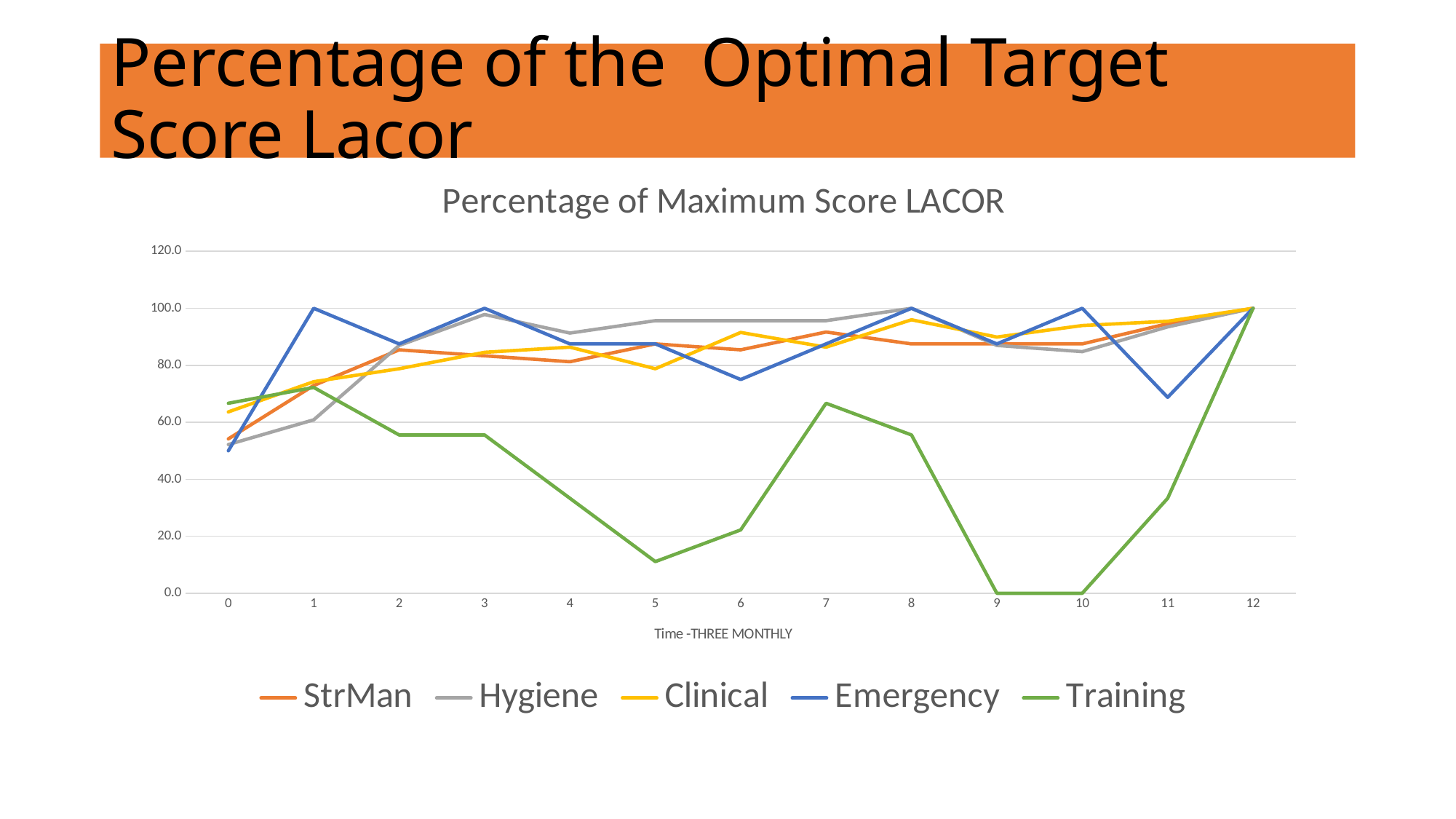
What is the title of the chart? Percentage of Maximum Score LACOR At time point 6, which is larger, the value for Clinical or the value for Emergency? Clinical Does the Training series rise or fall between time point 10 and time point 12? rise Is the value for Training at time point 7 greater or less than 60.0? greater What kind of chart is shown on the slide? line chart What is the value for Training at time point 9? 0.0 Which series has the lowest value at time point 5? Training How many time points are plotted along the x axis? 13 Is the value for Emergency at time point 11 greater or less than 80.0? less What is the value for Emergency at time point 1? 100.0 How many series does the legend list? 5 What is the x-axis label of the chart? Time -THREE MONTHLY